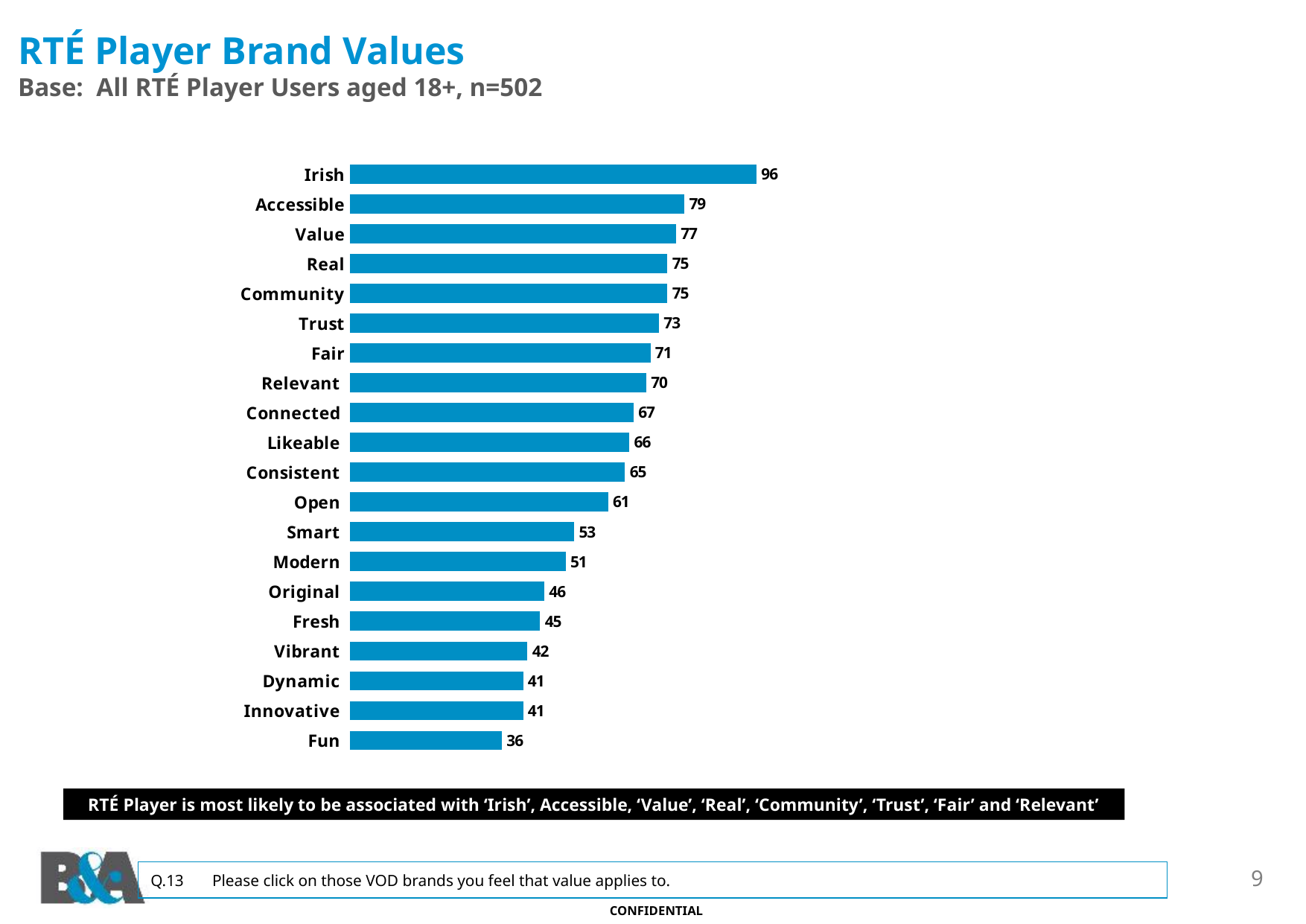
What kind of chart is shown on the slide? Bar chart What is the value for Fresh? 45 What is the difference between the values for Irish and Accessible? 17 What is the difference between the values for Open and Smart? 8 Which brand value has the lowest score? Fun What is the base described under the chart title? All RTÉ Player Users aged 18+, n=502 How many brand values are shown in the chart? 20 What is the value for Consistent? 65 Which has a higher value, Modern or Original? Modern Which has a higher value, Trust or Likeable? Trust Which brand value has the highest score? Irish What is the value for Irish? 96